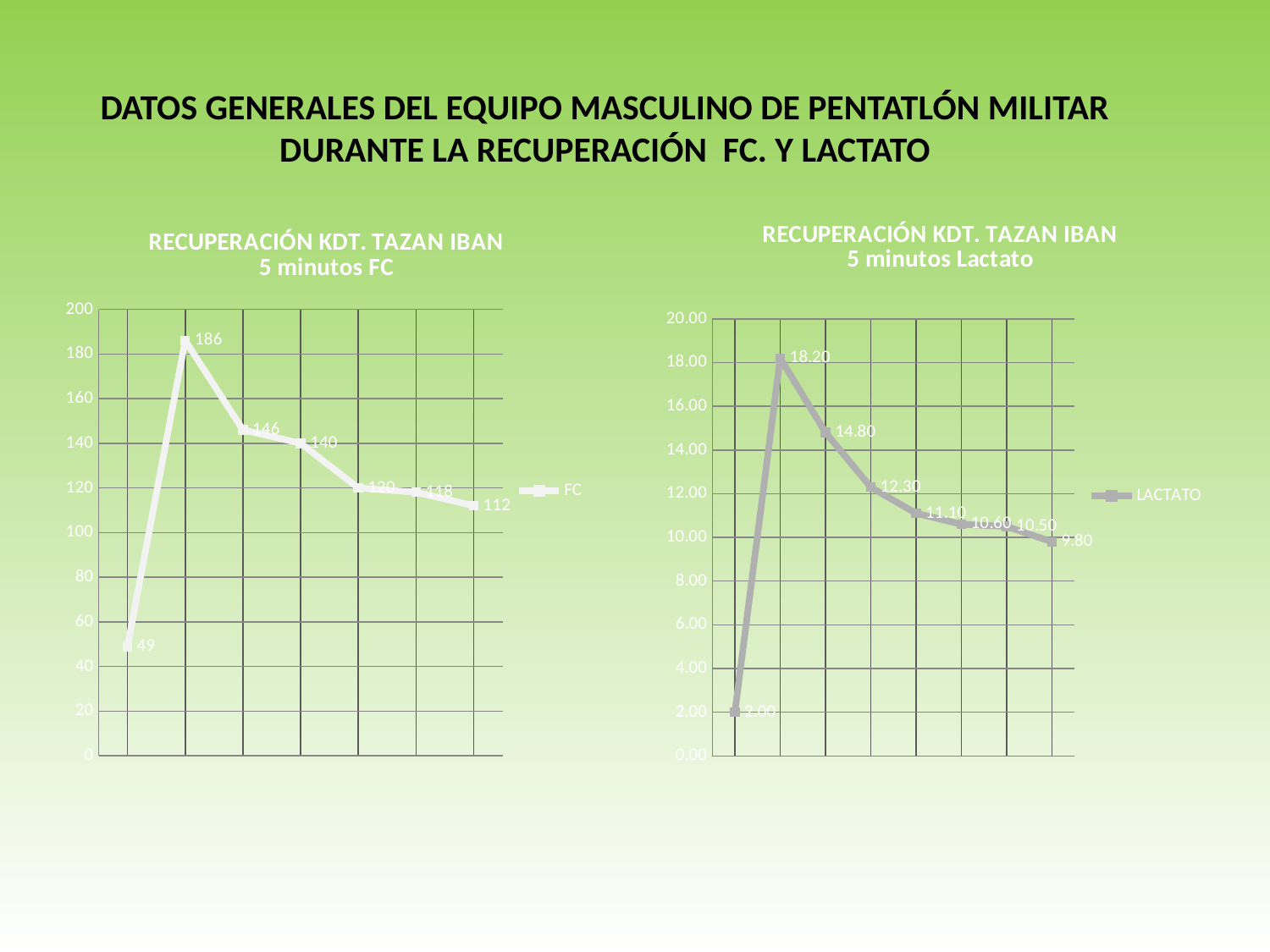
What type of chart is the '5 minutos FC' chart on the left? line chart In the '5 minutos FC' chart, what is the highest value plotted? 186 In the '5 minutos Lactato' chart, what is the value of the last data point? 9.80 How many data points are plotted in the '5 minutos Lactato' chart? 8 In the '5 minutos FC' chart, what is the lowest value plotted? 49 What series name does the legend of the '5 minutos Lactato' chart show? LACTATO In the '5 minutos Lactato' chart, do the values rise or fall after the second data point? fall In the '5 minutos Lactato' chart, what is the highest value plotted? 18.20 In the '5 minutos FC' chart, what is the value of the last data point? 112 How many data points are plotted in the '5 minutos FC' chart? 7 In the '5 minutos FC' chart, what is the difference between the peak value and the last value? 74 In the '5 minutos Lactato' chart, what is the value of the first data point? 2.00